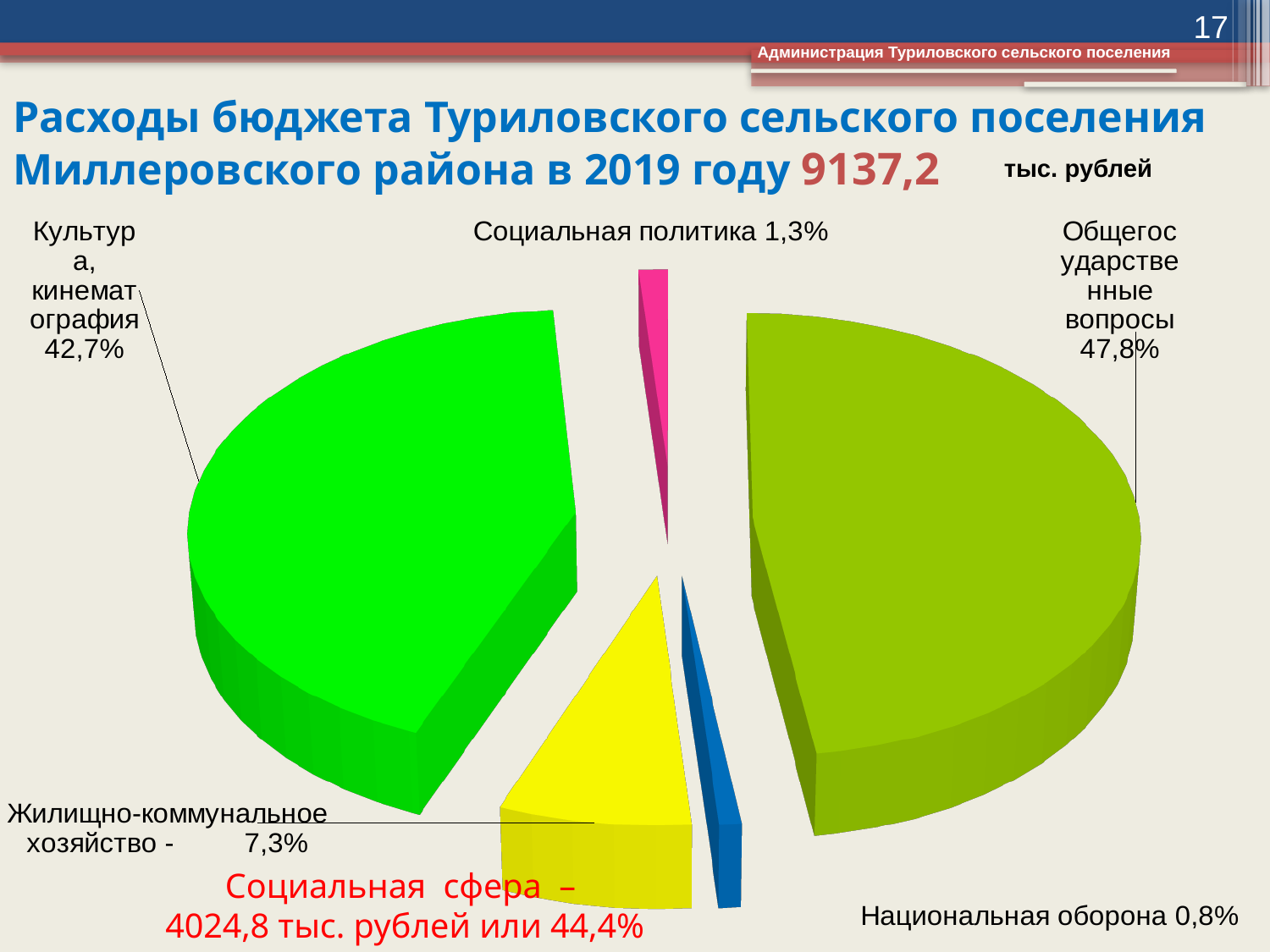
How many slices does the pie chart have? 5 Which category has the smallest slice of the pie? Национальная оборона Which category has the largest slice of the pie? Общегосударственные вопросы What is the value shown for Национальная оборона? 0,8% What share of the pie does Культура, кинематография have? 42,7% What total budget expenditure amount (in тыс. рублей) is given in the slide title? 9137,2 What is the value shown for Жилищно-коммунальное хозяйство? 7,3% What kind of chart is shown on the slide? pie chart Which is larger, the share for Жилищно-коммунальное хозяйство or the share for Социальная политика? Жилищно-коммунальное хозяйство What share of the pie does Общегосударственные вопросы have? 47,8% What is the value shown for Социальная политика? 1,3% What is the difference in percentage points between Общегосударственные вопросы and Культура, кинематография? 5,1